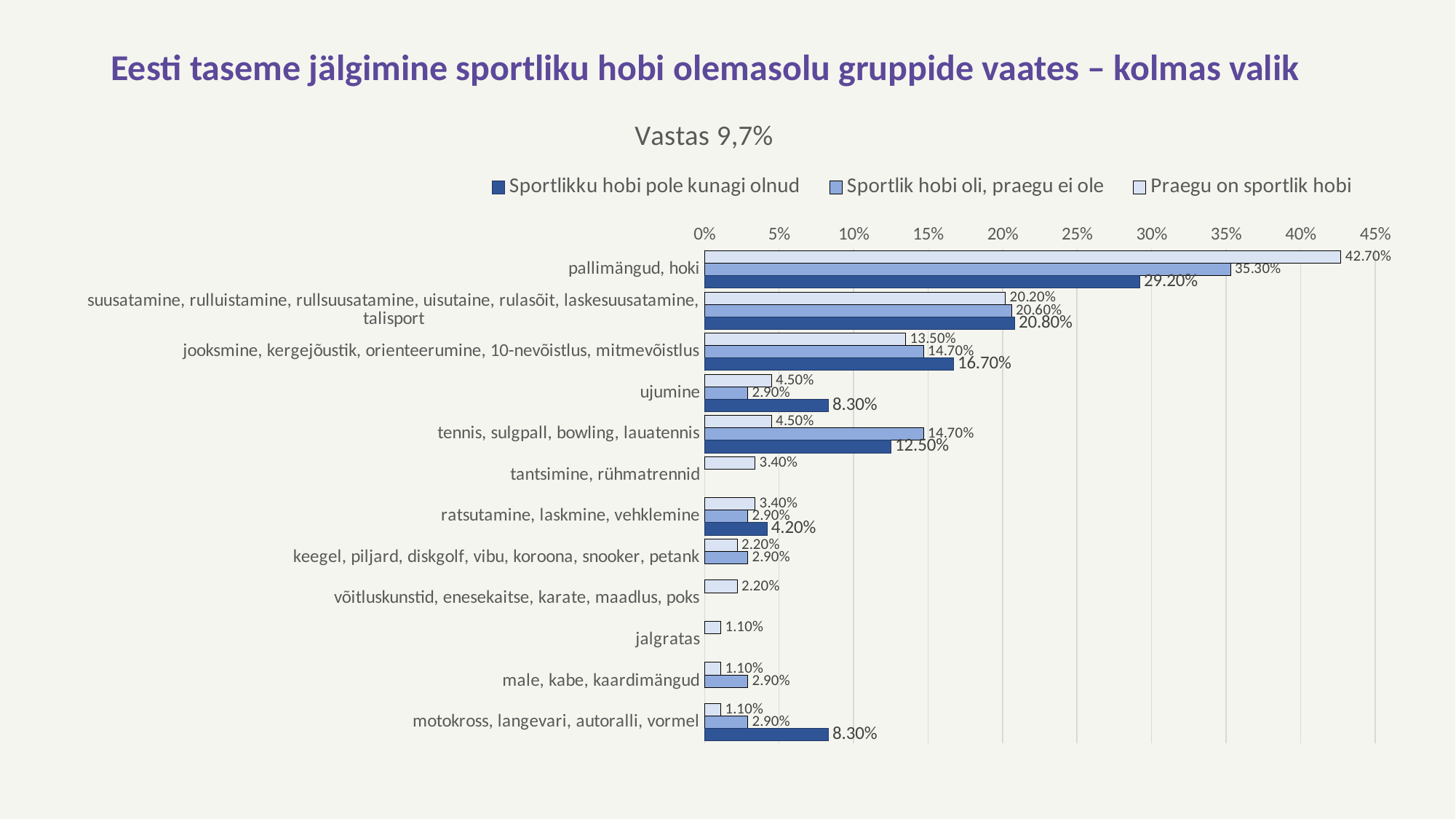
Is the value for 'Sportlikku hobi pole kunagi olnud' in 'pallimängud, hoki' greater or less than 25%? greater What is the value for 'Sportlik hobi oli, praegu ei ole' in the category 'tennis, sulgpall, bowling, lauatennis'? 14.70% What is the value for 'Praegu on sportlik hobi' in the category 'pallimängud, hoki'? 42.70% How many categories are shown on the chart? 12 What is the value for 'Praegu on sportlik hobi' in the category 'jalgratas'? 1.10% What is the value for 'Sportlikku hobi pole kunagi olnud' in the category 'ujumine'? 8.30% What is the difference between the 'Praegu on sportlik hobi' and 'Sportlikku hobi pole kunagi olnud' values for 'pallimängud, hoki'? 13.50% What kind of chart is shown on the slide? bar chart For 'ujumine', which is larger: the value for 'Praegu on sportlik hobi' or for 'Sportlikku hobi pole kunagi olnud'? Sportlikku hobi pole kunagi olnud How many series does the legend list? 3 What is the title of the chart? Vastas 9,7% Which category has the highest value for 'Praegu on sportlik hobi'? pallimängud, hoki